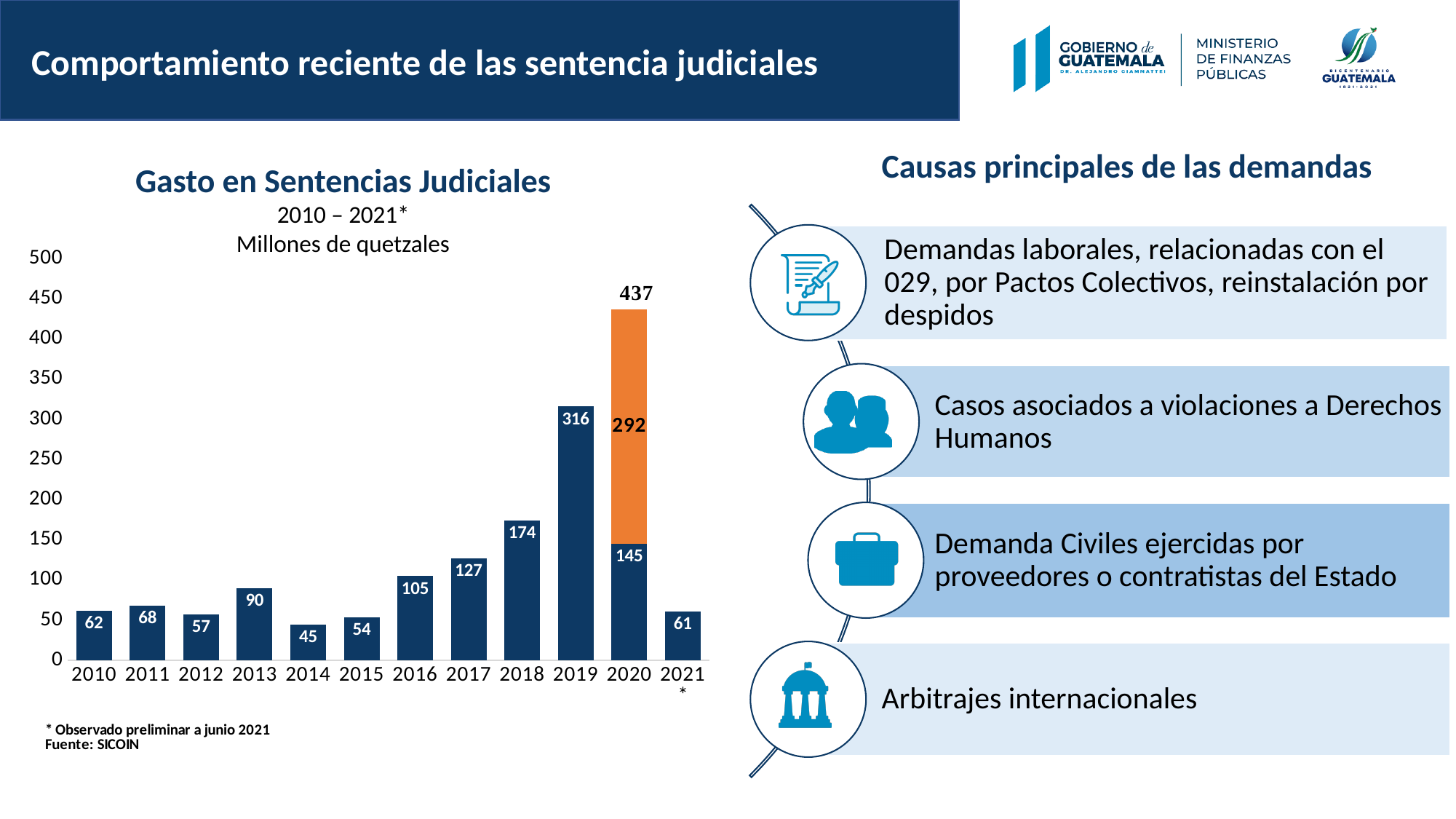
What kind of chart is Gasto en Sentencias Judiciales? bar chart Do the values generally rise or fall from 2015 to 2019? rise How many years are shown on the x axis of the chart? 12 What is the value of the orange segment of the 2020 bar? 292 What is the value for 2014 in the Gasto en Sentencias Judiciales chart? 45 Which year has the highest total value in the chart? 2020 What is the difference between the values for 2019 and 2018? 142 Which is larger, the value for 2013 or the value for 2016? 2016 What unit is stated in the subtitle of the chart? Millones de quetzales Which year has the lowest value in the chart? 2014 What is the value for 2019 in the Gasto en Sentencias Judiciales chart? 316 What is the total shown above the stacked bar for 2020? 437